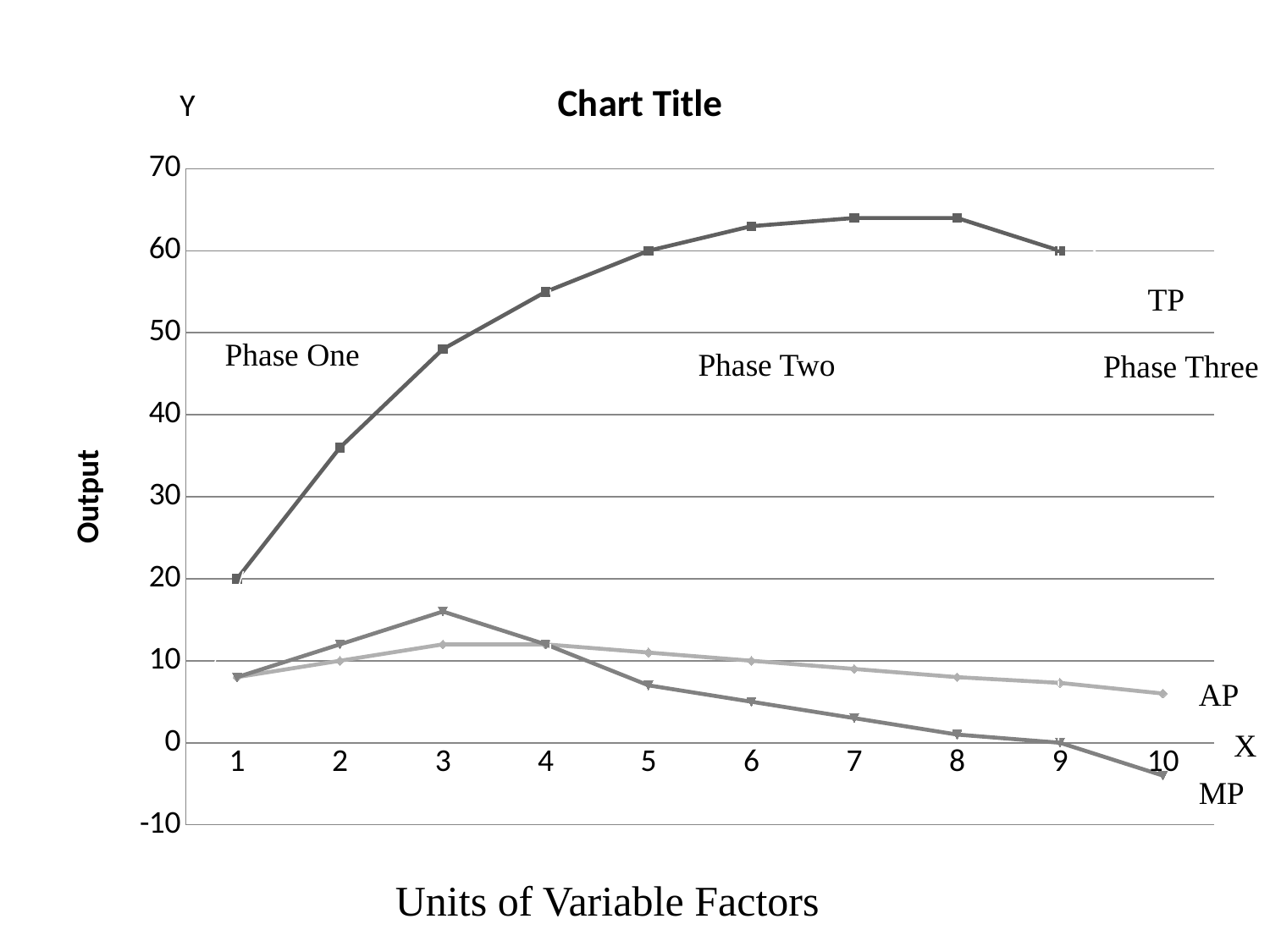
What is the value of AP at 2 units of variable factors? 10 How many units of variable factors are shown on the x axis? 10 Is the value of TP at 7 units greater or less than 60? greater What is the value of TP at 1 unit of variable factors? 20 What is the value of MP at 9 units of variable factors? 0 What is the value of TP at 5 units of variable factors? 60 What kind of chart is shown on the slide? line chart At how many units of variable factors is MP at its lowest value? 10 Is the value of MP at 10 units greater or less than 0? less Is the value of AP at 10 units greater or less than 10? less At how many units of variable factors does MP reach its highest value? 3 At 5 units of variable factors, which is larger, TP or AP? TP